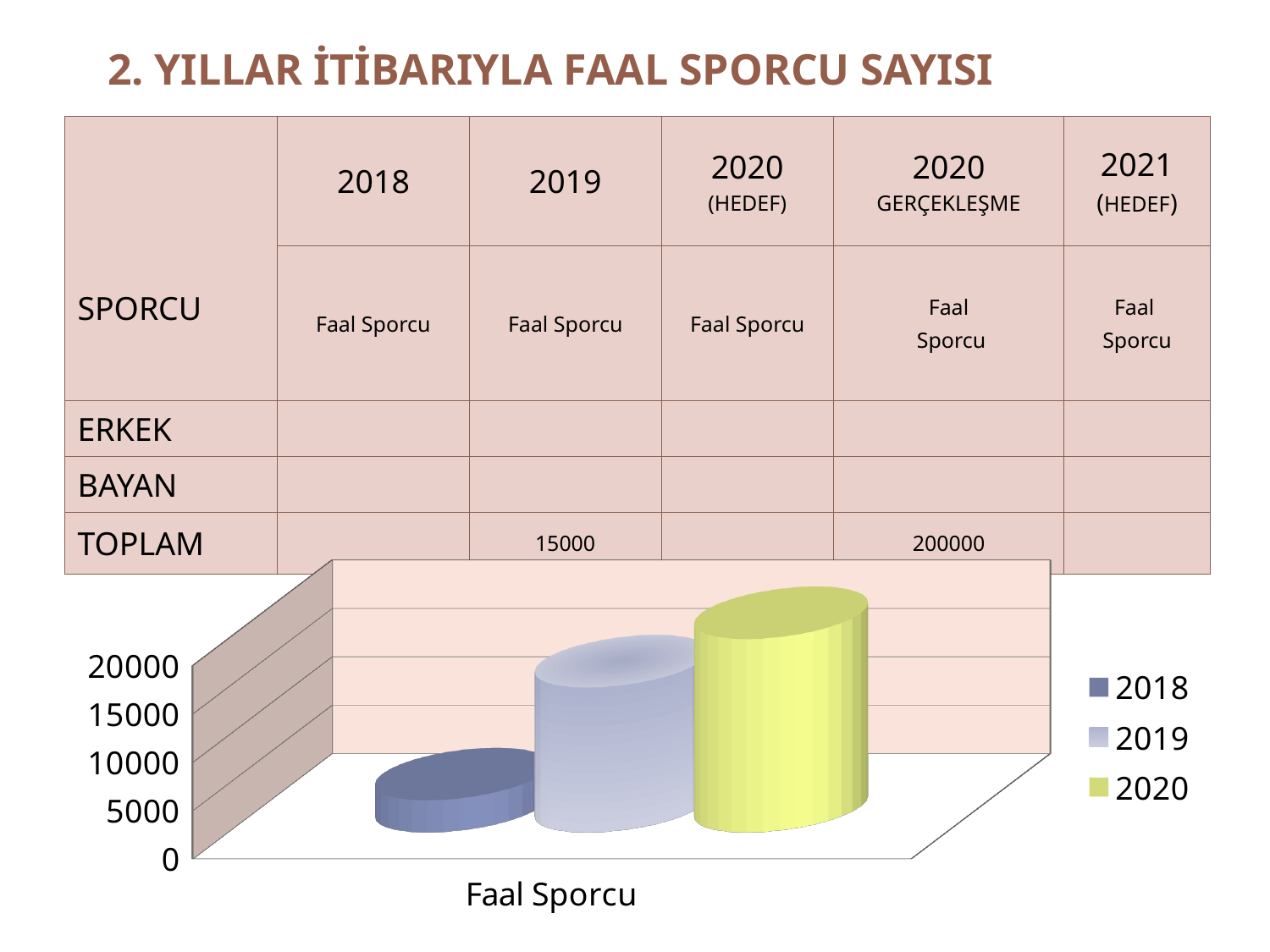
Which series has the lowest bar in the chart? 2018 How many series does the chart legend list? 3 Is the value for 2018 in the chart greater or less than 5000? less How many categories are shown on the x axis of the chart? 1 Which is larger in the chart, the bar for 2019 or the bar for 2018? 2019 Which is larger in the chart, the bar for 2020 or the bar for 2019? 2020 What is the category label on the x axis of the chart? Faal Sporcu What kind of chart is shown on the slide? bar chart Is the value for 2020 in the chart greater or less than 15000? greater Do the bars rise or fall from the 2018 series to the 2020 series in the chart? rise Which series has the highest bar in the chart? 2020 Is the value for 2019 in the chart greater or less than 10000? greater